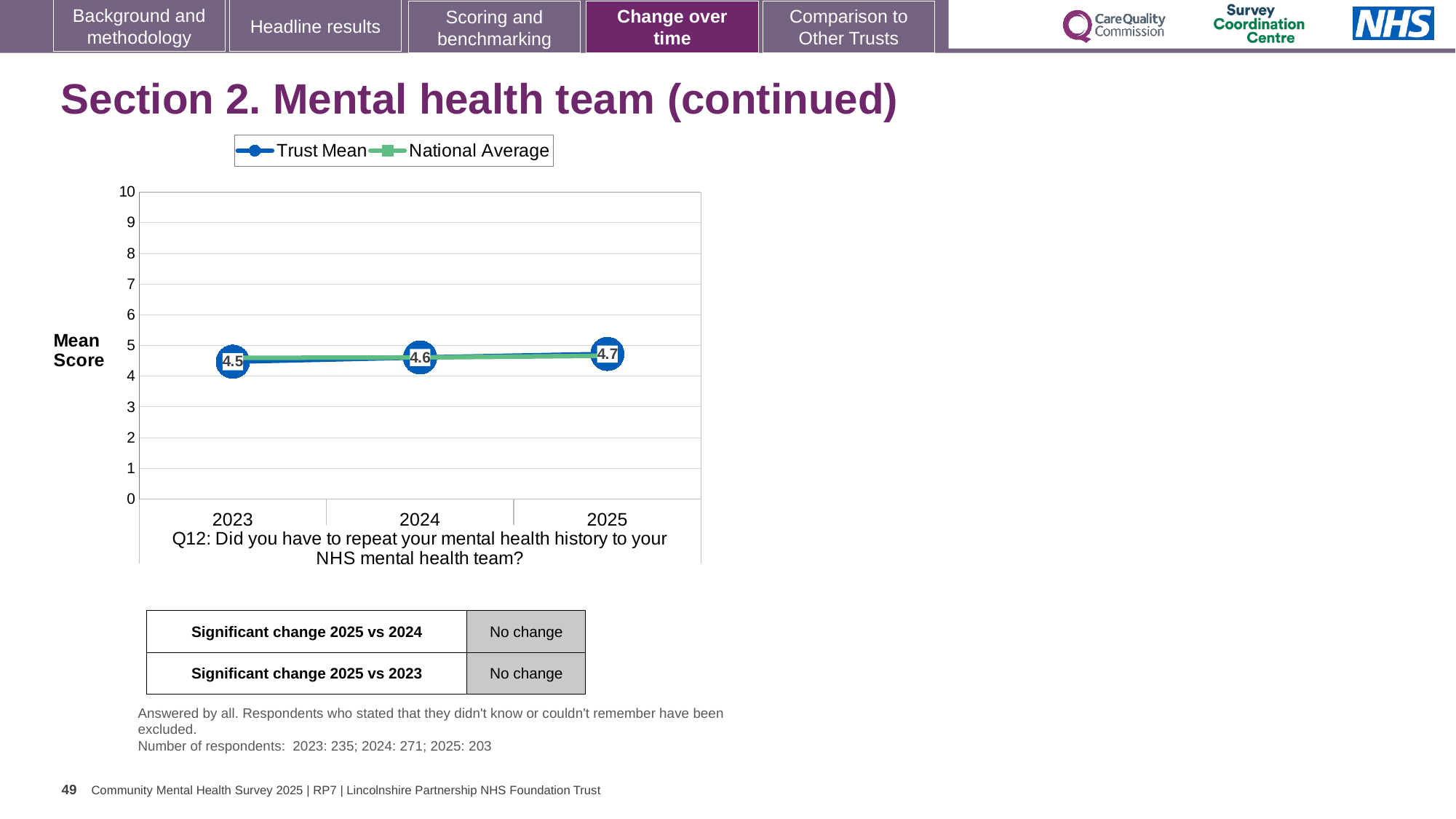
What is the Trust Mean score for 2025? 4.7 In which year is the Trust Mean score highest? 2025 What kind of chart is shown on the slide? line chart In which year is the Trust Mean score lowest? 2023 What is the Trust Mean score for 2023? 4.5 Does the Trust Mean score rise or fall from 2023 to 2025? rise What are the two series named in the chart legend? Trust Mean and National Average How many series does the chart legend list? 2 What is the difference between the Trust Mean score in 2025 and in 2023? 0.2 What is the Trust Mean score for 2024? 4.6 Is the Trust Mean score for 2025 greater or less than 5? less How many years are shown on the x axis of the chart? 3